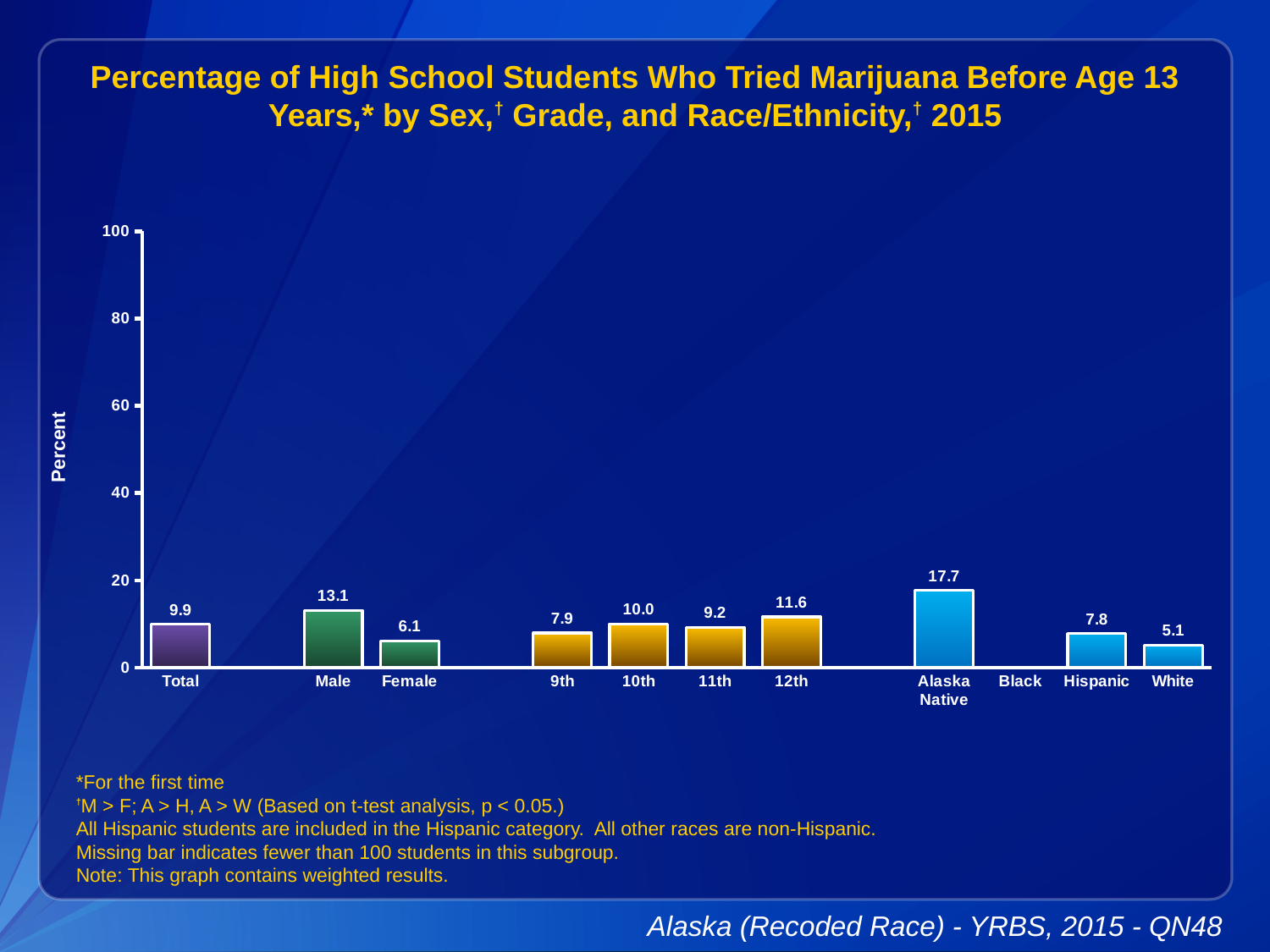
What is the value for Male? 13.1 What is the difference between the Male and Female values? 7.0 Which category has no bar shown? Black Is the value for Alaska Native greater or less than 20? less Which is larger, the value for 10th grade or the value for 11th grade? 10th What kind of chart is shown? bar chart What is the label on the vertical axis? Percent Which category has the lowest value among the bars shown? White What is the value for Alaska Native? 17.7 What is the value for 12th grade? 11.6 How many bars are plotted on the chart? 10 Which category has the highest value? Alaska Native